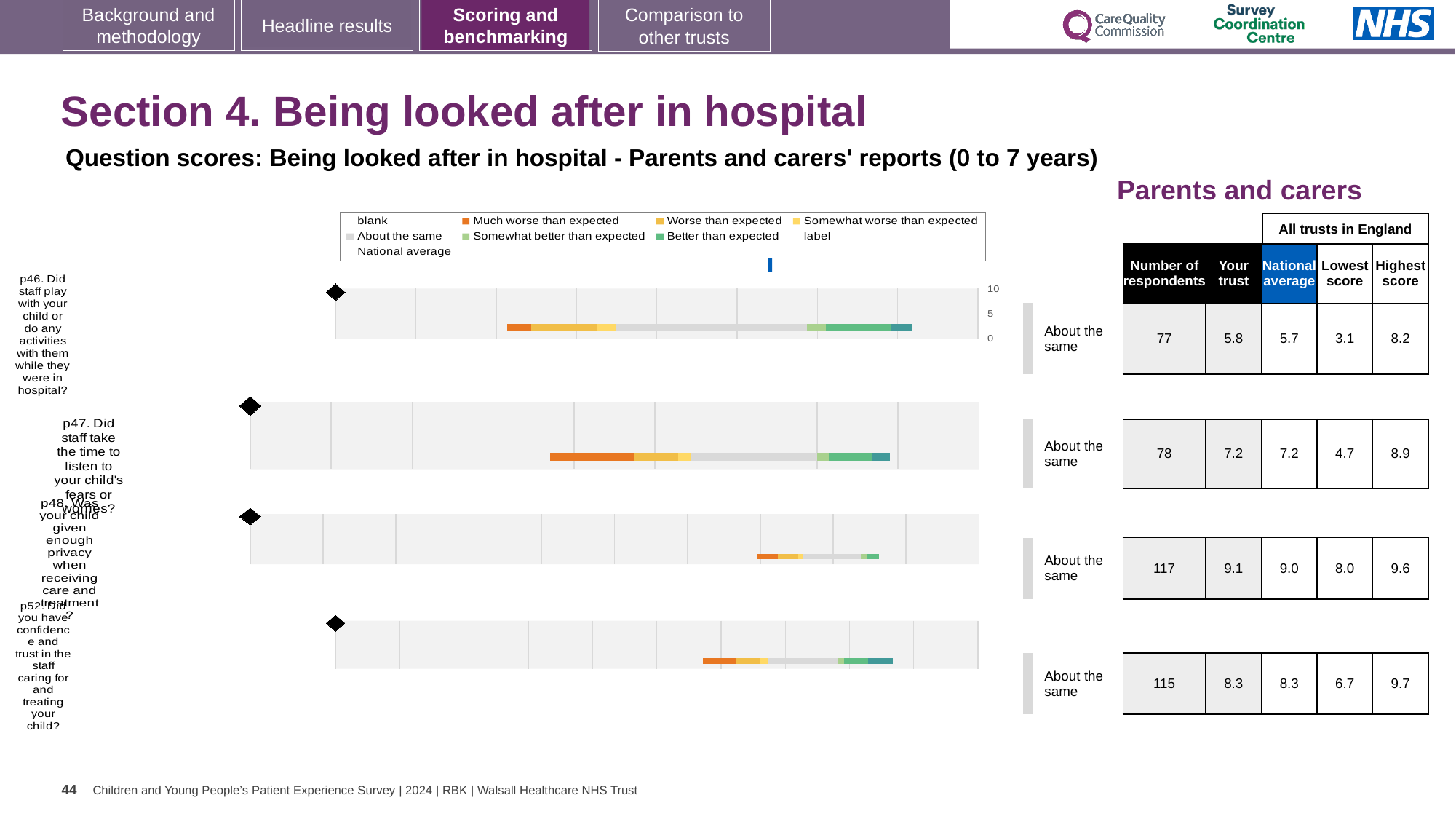
What is the national average score for p48 (Was your child given enough privacy when receiving care and treatment?)? 9.0 What kind of chart is used to show the question scores on this slide? bar chart What is the number of respondents for p47 (Did staff take the time to listen to your child's fears or worries?)? 78 What is the 'Your trust' score for p46 (Did staff play with your child or do any activities with them while they were in hospital?)? 5.8 For p46, what is the difference between the highest score and the lowest score among all trusts in England? 5.1 Which question has the highest 'Your trust' score? p48 How many entries does the chart legend list? 9 Which question has the lowest 'Your trust' score? p46 For p46, which is larger: the 'Your trust' score or the national average? Your trust How many survey questions (charts) are shown on the slide? 4 What benchmark category is shown for all four questions on this slide? About the same What is the highest score among all trusts in England for p52 (Did you have confidence and trust in the staff caring for and treating your child?)? 9.7